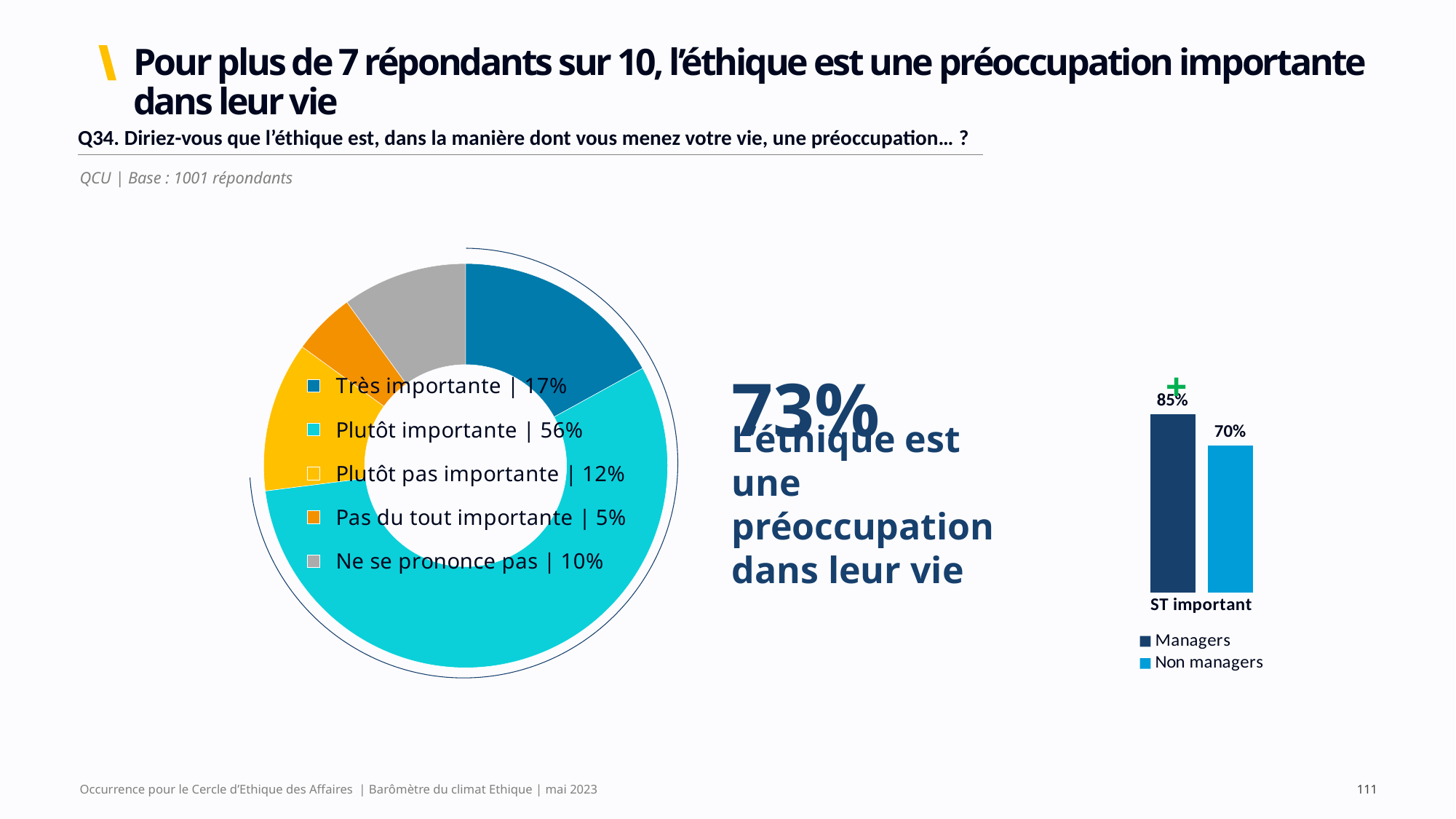
In the donut chart on the left, which category has the smallest share? Pas du tout importante In the donut chart on the left, what is the difference between "Plutôt pas importante" and "Ne se prononce pas"? 2 percentage points In the bar chart on the right, how many series does the legend list? 2 In the donut chart on the left, what share of respondents answered "Pas du tout importante"? 5% What kind of chart is shown on the left of the slide? Donut (pie) chart In the bar chart on the right (ST important), what is the value for Managers? 85% In the donut chart on the left, what share of respondents answered "Plutôt importante"? 56% In the bar chart on the right (ST important), what is the value for Non managers? 70% In the donut chart on the left, what share of respondents answered "Très importante"? 17% In the donut chart on the left, which category has the largest share? Plutôt importante In the bar chart on the right (ST important), what is the difference between Managers and Non managers? 15 percentage points In the donut chart on the left, how many categories does the legend list? 5